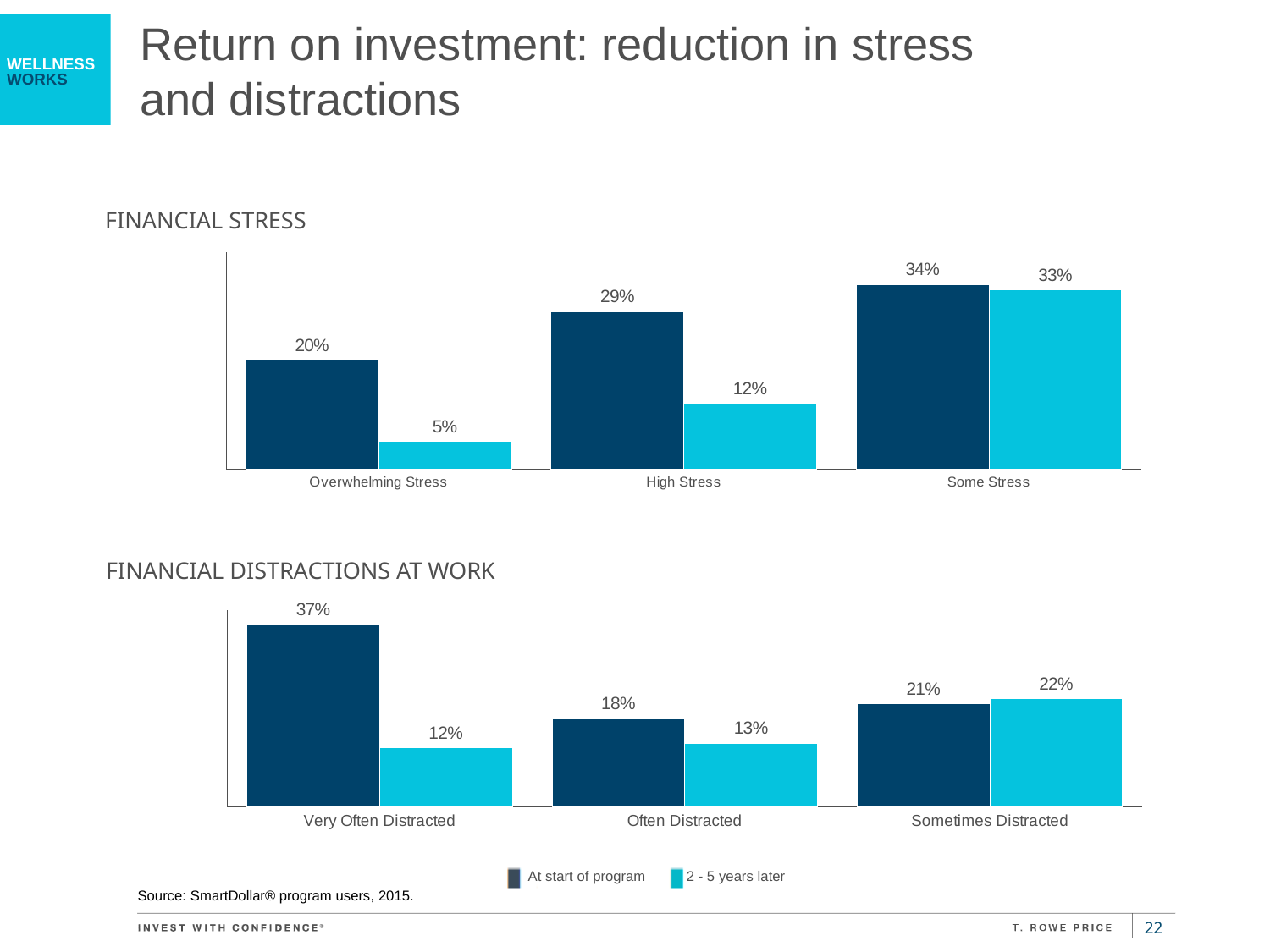
How many categories does the Financial Stress chart show? 3 In the Financial Distractions at Work chart, which category has the lowest value 2 - 5 years later? Very Often Distracted How many series does the legend list? 2 In the Financial Stress chart, what is the value for Overwhelming Stress 2 - 5 years later? 5% In the Financial Stress chart, what is the difference between the start of program and 2 - 5 years later values for High Stress? 17% In the Financial Stress chart, which category has the highest value at start of program? Some Stress In the Financial Distractions at Work chart, what is the value for Sometimes Distracted 2 - 5 years later? 22% In the Financial Distractions at Work chart, what is the value for Very Often Distracted at start of program? 37% In the Financial Stress chart, what is the value for High Stress at start of program? 29% In the Financial Distractions at Work chart, what is the difference between the start of program and 2 - 5 years later values for Very Often Distracted? 25% In the Financial Distractions at Work chart, which is larger for Sometimes Distracted: at start of program or 2 - 5 years later? 2 - 5 years later What kind of chart is the Financial Distractions at Work chart? Bar chart